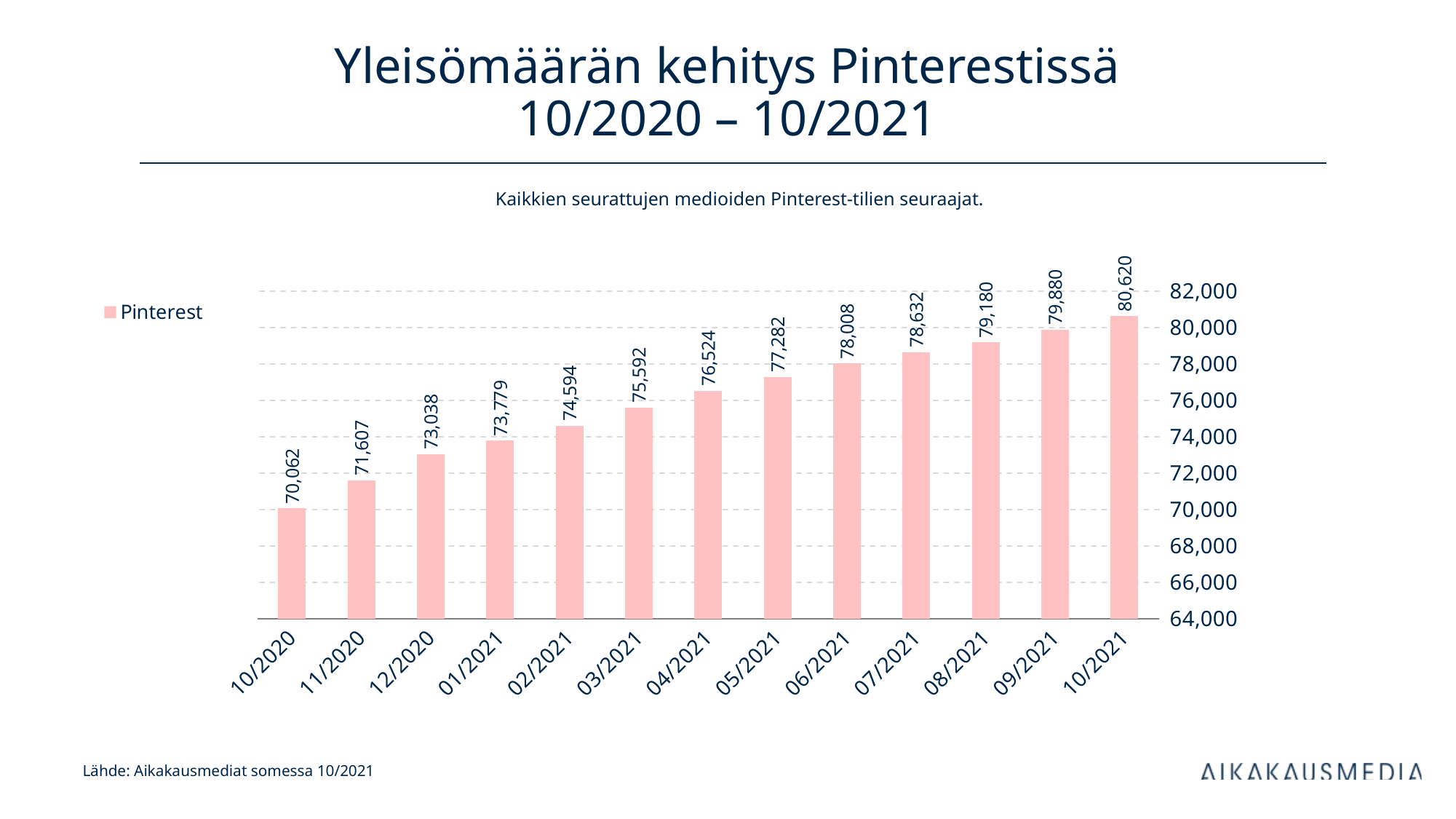
Is the value for 04/2021 greater or less than 78,000? less What is the difference between the values for 10/2021 and 10/2020? 10,558 Which is larger, the value for 01/2021 or the value for 07/2021? 07/2021 What is the difference between the values for 06/2021 and 05/2021? 726 Which month has the highest value? 10/2021 Do the values rise or fall from 10/2020 to 10/2021? rise What is the value for 10/2021? 80,620 What is the value for 03/2021? 75,592 Which month has the lowest value? 10/2020 What kind of chart is this? bar chart How many months are shown on the x axis? 13 What is the value for 10/2020? 70,062